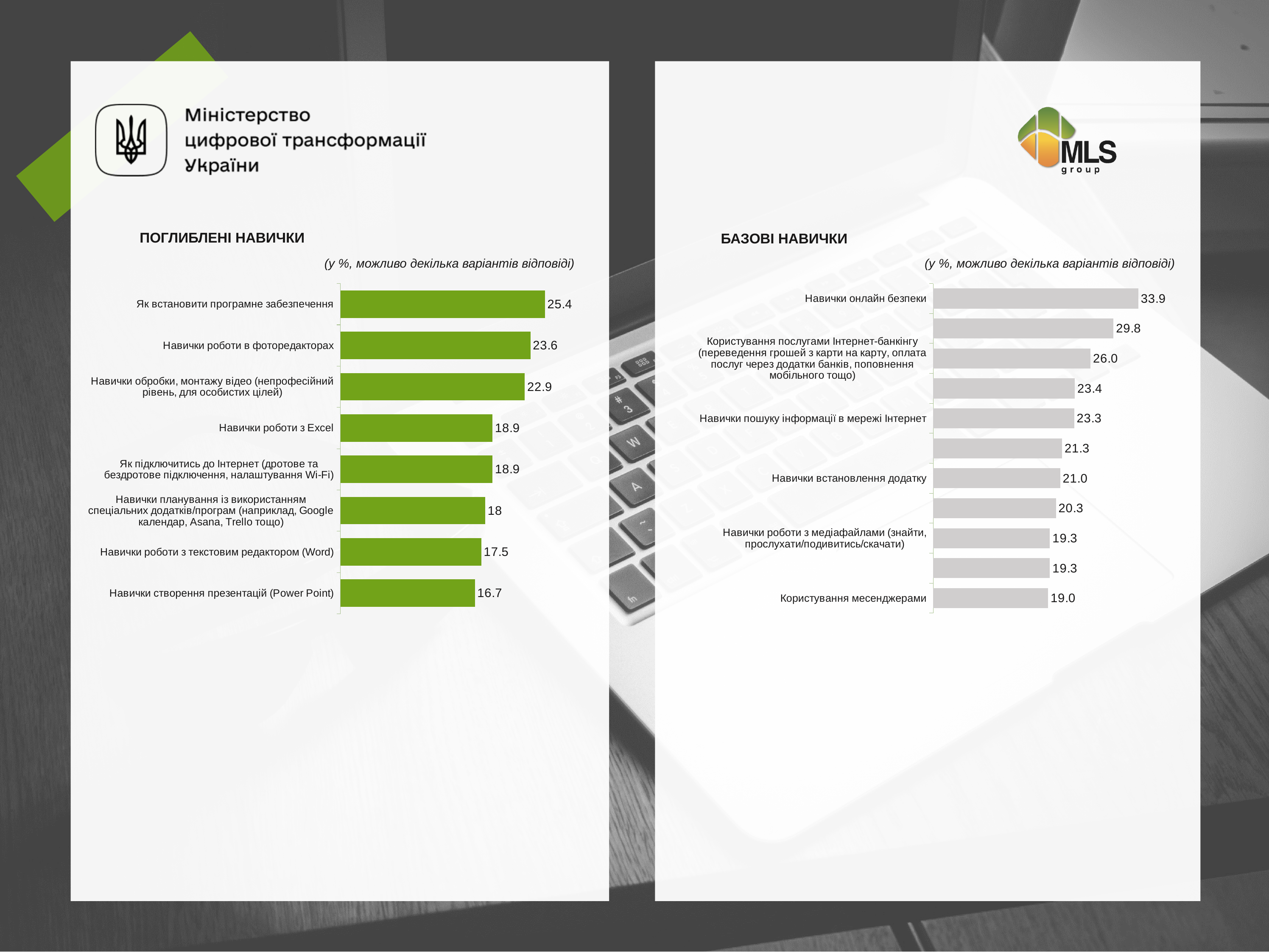
In the ПОГЛИБЛЕНІ НАВИЧКИ chart, what is the value for Навички роботи з Excel? 18.9 What type of chart is the ПОГЛИБЛЕНІ НАВИЧКИ chart? Bar chart In the ПОГЛИБЛЕНІ НАВИЧКИ chart, which category has the lowest value? Навички створення презентацій (Power Point) In the БАЗОВІ НАВИЧКИ chart, which is larger: Навички пошуку інформації в мережі Інтернет or Навички встановлення додатку? Навички пошуку інформації в мережі Інтернет In the ПОГЛИБЛЕНІ НАВИЧКИ chart, how many categories are shown? 8 In the БАЗОВІ НАВИЧКИ chart, what is the value for Навички онлайн безпеки? 33.9 In the БАЗОВІ НАВИЧКИ chart, what is the value for Користування месенджерами? 19.0 In the ПОГЛИБЛЕНІ НАВИЧКИ chart, what is the value for Навички створення презентацій (Power Point)? 16.7 In the ПОГЛИБЛЕНІ НАВИЧКИ chart, which category has the highest value? Як встановити програмне забезпечення In the ПОГЛИБЛЕНІ НАВИЧКИ chart, what is the difference between Як встановити програмне забезпечення and Навички роботи в фоторедакторах? 1.8 In the БАЗОВІ НАВИЧКИ chart, what is the value for Навички встановлення додатку? 21.0 In the БАЗОВІ НАВИЧКИ chart, how many bars are shown? 11